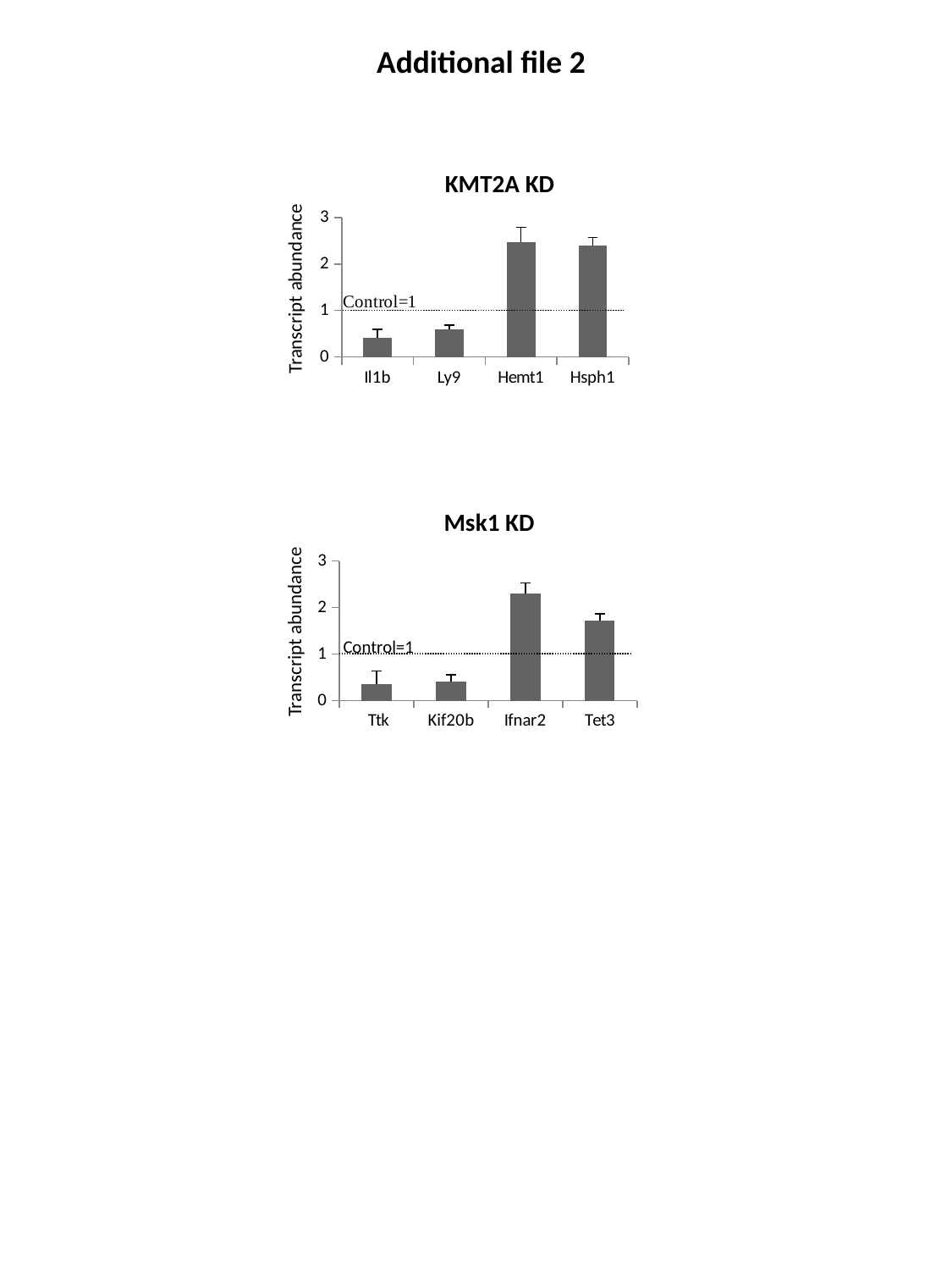
In the KMT2A KD chart, which category has the lowest transcript abundance? Il1b What is the y-axis label of the Msk1 KD chart? Transcript abundance In the KMT2A KD chart, is the value for Il1b greater or less than 1? less In the KMT2A KD chart, is the value for Hemt1 greater or less than 2? greater In the Msk1 KD chart, which category has the highest transcript abundance? Ifnar2 What kind of chart is the KMT2A KD chart? bar chart In the Msk1 KD chart, is the value for Kif20b greater or less than 1? less In the KMT2A KD chart, which is larger, the value for Ly9 or the value for Hsph1? Hsph1 How many categories are shown on the x axis of the Msk1 KD chart? 4 How many categories are shown on the x axis of the KMT2A KD chart? 4 In the Msk1 KD chart, which is larger, the value for Ifnar2 or the value for Tet3? Ifnar2